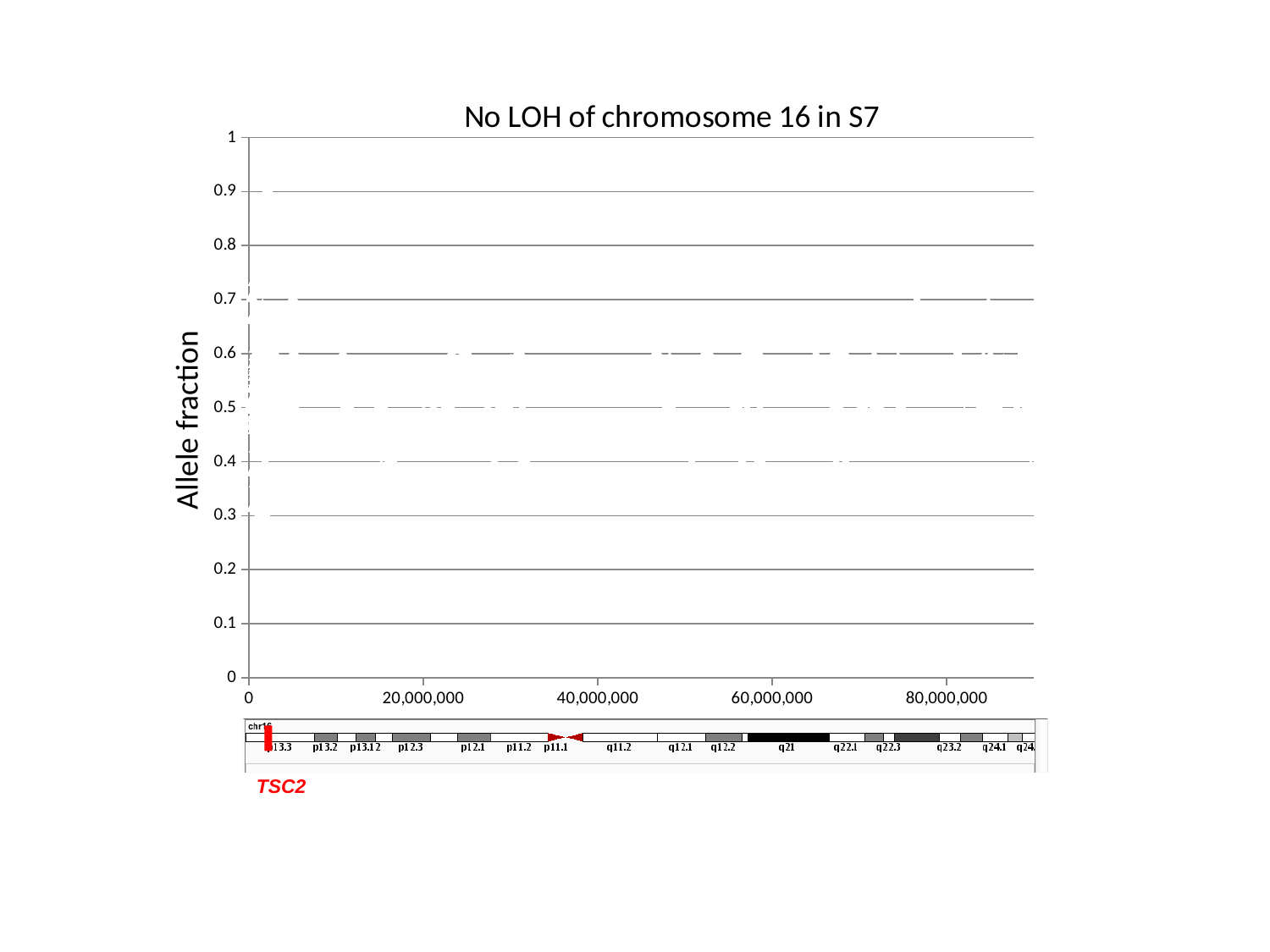
What is the largest tick label shown on the x axis of the chart? 80,000,000 What kind of chart is shown on the slide? scatter plot Which gene is labelled in red below the chromosome ideogram? TSC2 Which chromosome is shown in the ideogram below the chart? chr16 Do the plotted allele fraction values show a clear rising or falling trend along the x axis? no